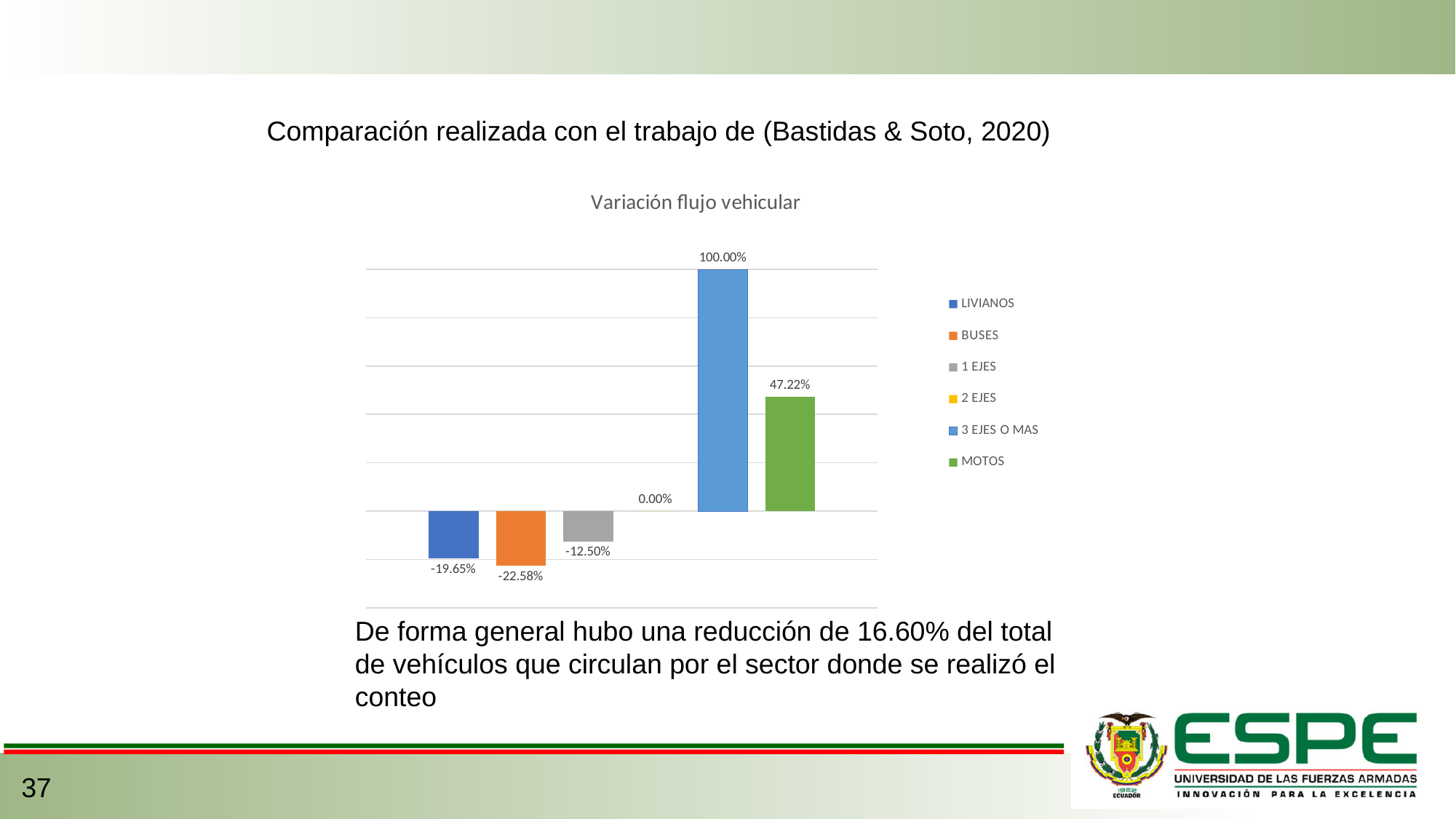
Which series has the lowest value? BUSES What is the value for 1 EJES? -12.50% How many series does the legend list? 6 Which series has the highest value? 3 EJES O MAS What is the title of the chart? Variación flujo vehicular What is the value for 3 EJES O MAS? 100.00% What is the value for MOTOS? 47.22% What is the difference between the value for 3 EJES O MAS and the value for MOTOS? 52.78% What kind of chart is shown on the slide? bar chart What is the value for BUSES? -22.58% Which is larger, the value for MOTOS or the value for 3 EJES O MAS? 3 EJES O MAS What is the value for LIVIANOS? -19.65%